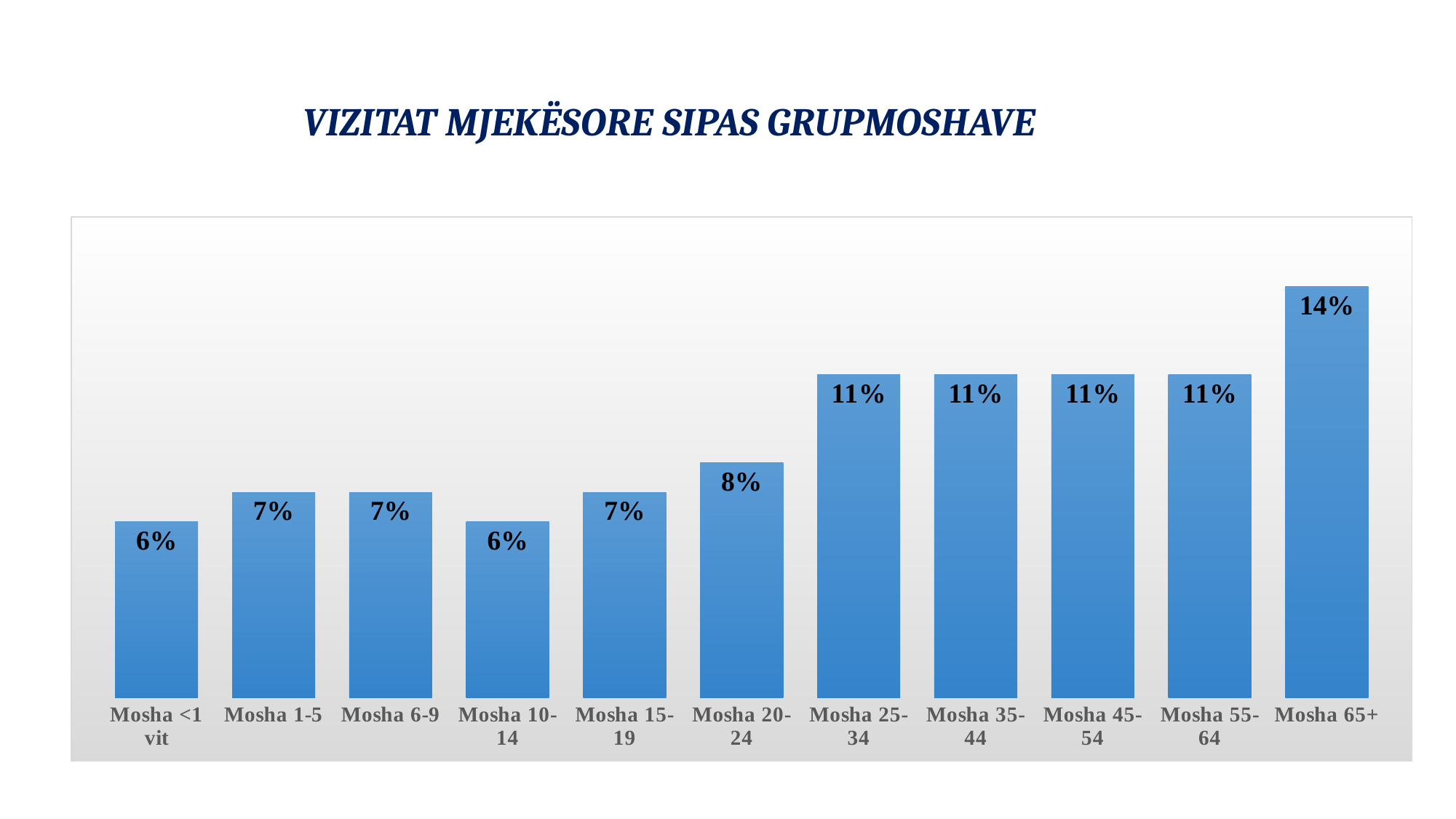
What is the difference between the values for Mosha 20-24 and Mosha <1 vit? 2% Which age group has the highest value? Mosha 65+ What is the value for Mosha 65+? 14% What kind of chart is shown on the slide? Bar chart What is the difference between the values for Mosha 65+ and Mosha 25-34? 3% How many age groups are shown in the chart? 11 Which is larger, the value for Mosha 20-24 or the value for Mosha 15-19? Mosha 20-24 What is the value for Mosha 20-24? 8% What is the value for Mosha 10-14? 6% What is the title of the chart? VIZITAT MJEKËSORE SIPAS GRUPMOSHAVE Do the values generally rise or fall from the youngest to the oldest age group? Rise What is the value for Mosha 1-5? 7%